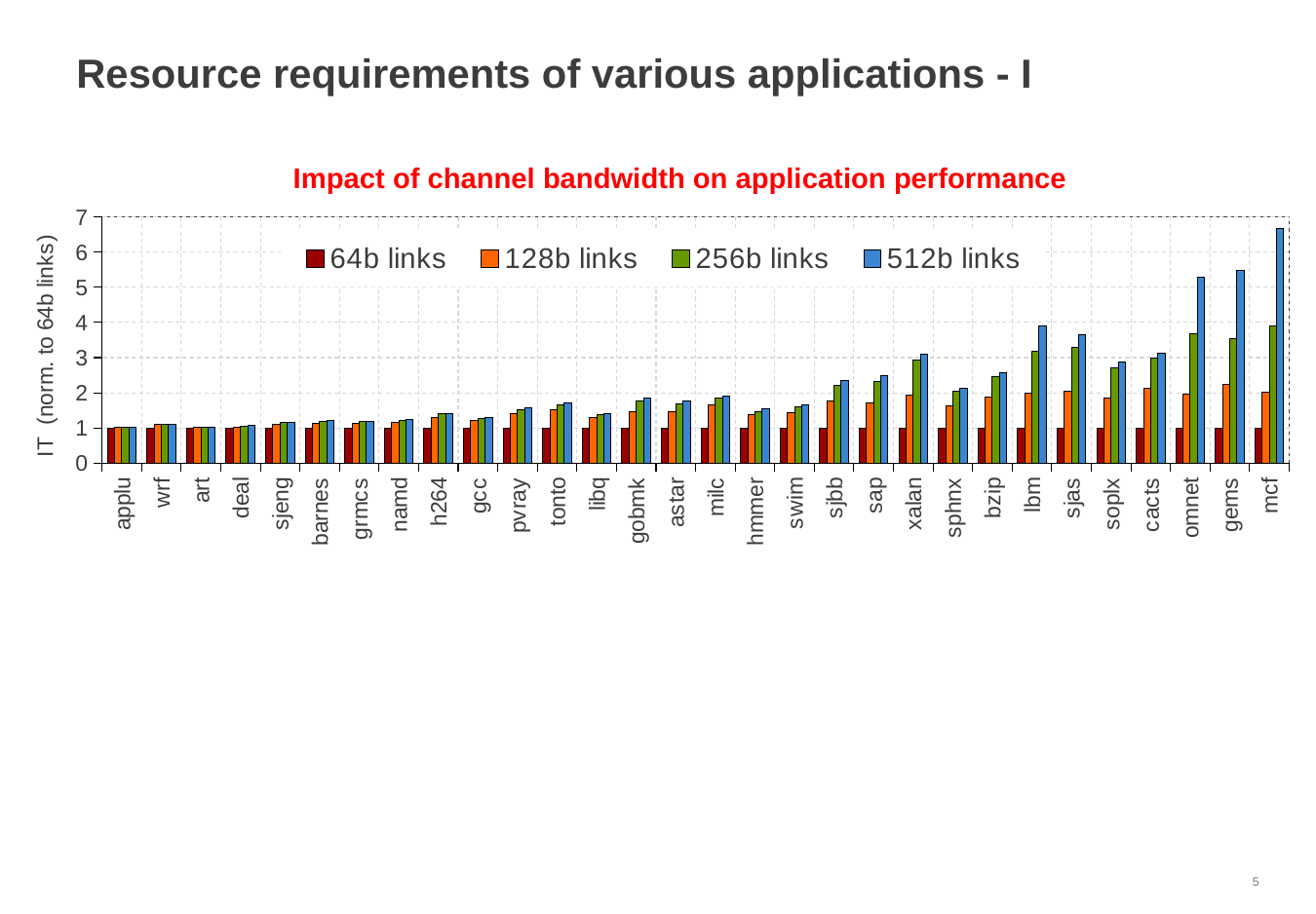
Is the value for sjas with 512b links greater or less than 3? greater Is the value for applu with 512b links greater or less than 2? less Which application has the highest value for 512b links? mcf Which is larger for 512b links: mcf or gems? mcf What is the title of the chart? Impact of channel bandwidth on application performance Is the value for mcf with 512b links greater or less than 6? greater How many applications (categories) are shown on the x axis? 30 What is the value for 64b links for every application? 1 How many series does the legend list? 4 Do the 512b links values generally rise or fall from left to right along the x axis? rise What kind of chart is shown on the slide? bar chart